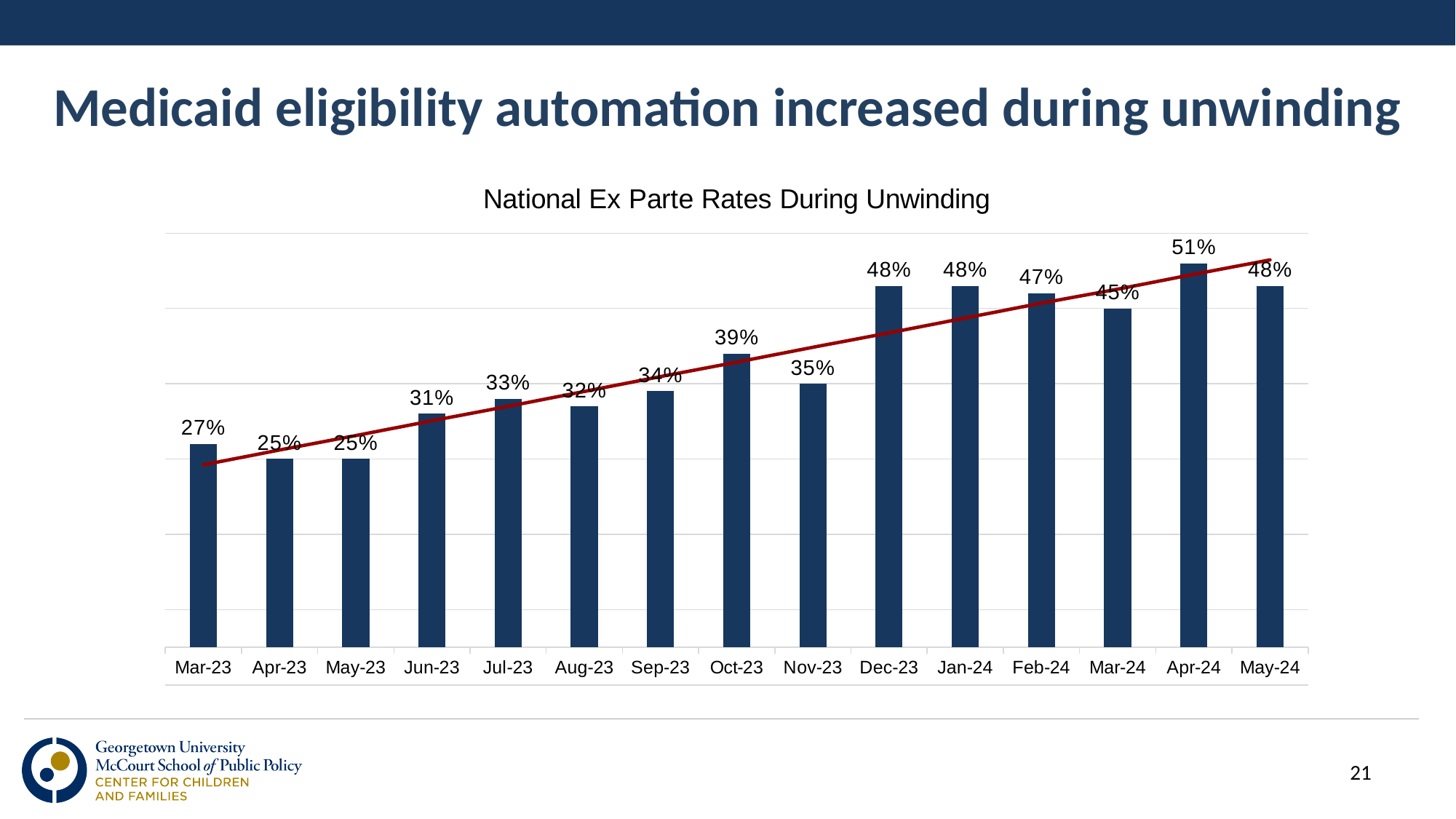
What kind of chart is used to show the national ex parte rates? Bar chart How many months are shown on the x axis of the chart? 15 What is the national ex parte rate for Mar-23? 27% What colour is the trend line drawn across the bars? Red What is the national ex parte rate for May-24? 48% Do the national ex parte rates generally rise or fall from Mar-23 to May-24? Rise Which month has the highest national ex parte rate? Apr-24 What is the lowest national ex parte rate shown on the chart? 25% What is the title of the chart? National Ex Parte Rates During Unwinding Which month has a higher ex parte rate, Nov-23 or Dec-23? Dec-23 What is the difference between the ex parte rate in Apr-24 and Mar-23? 24 percentage points What is the national ex parte rate for Oct-23? 39%